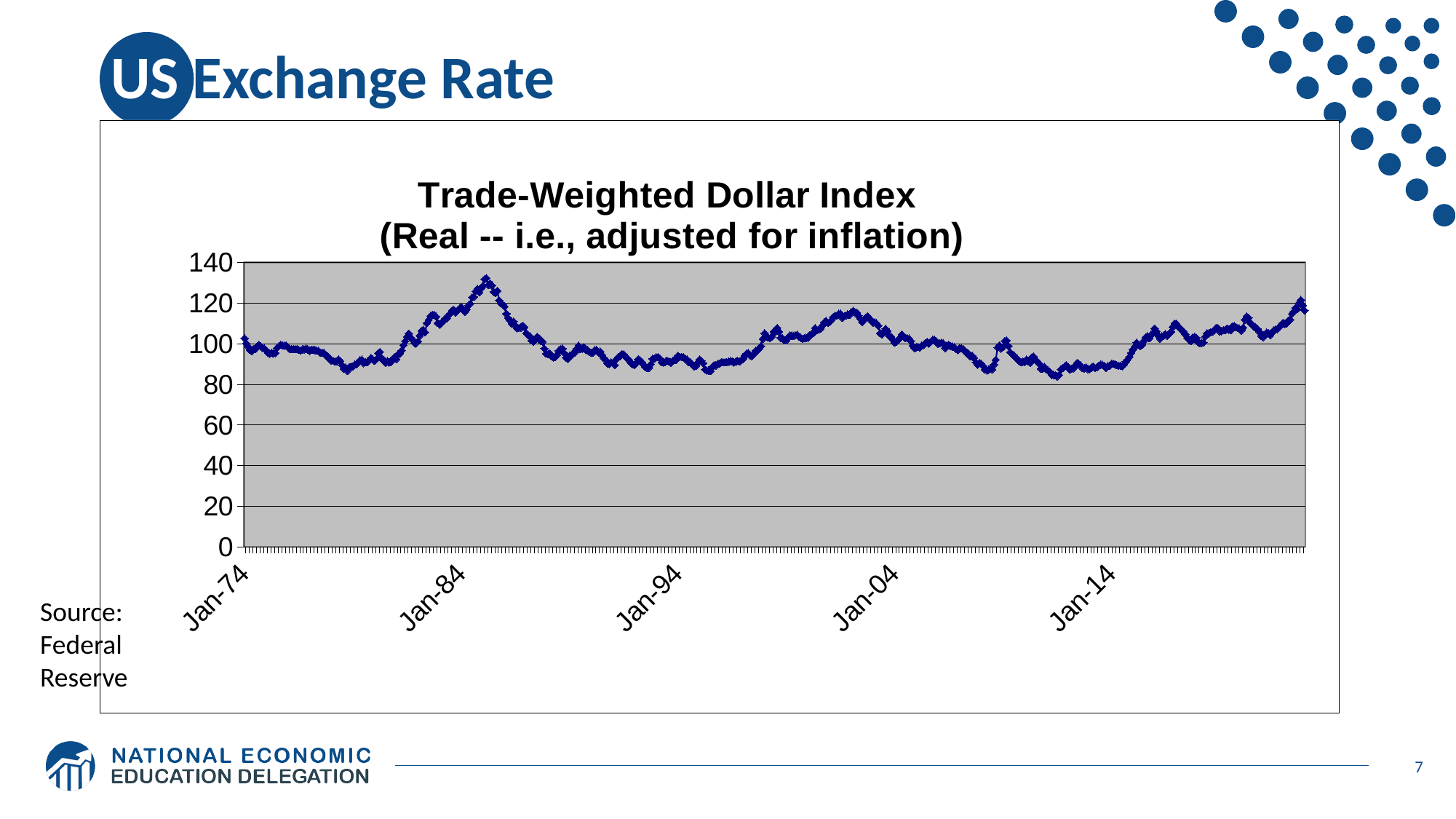
Is the value of the index at Jan-14 greater or less than 100? less Is the value of the index at Jan-94 greater or less than 100? less Is the value of the index at Jan-84 greater or less than 100? greater What is the highest value shown on the y-axis? 140 What is the title of the chart? Trade-Weighted Dollar Index (Real -- i.e., adjusted for inflation) What kind of chart is shown on the slide? line chart Which labeled x-axis date is the highest point of the index closest to: Jan-74, Jan-84, Jan-94, Jan-04 or Jan-14? Jan-84 Does the index rise or fall overall between Jan-84 and Jan-94? fall Does the index rise or fall overall from Jan-14 to the end of the series? rise How many data series are plotted in the chart? 1